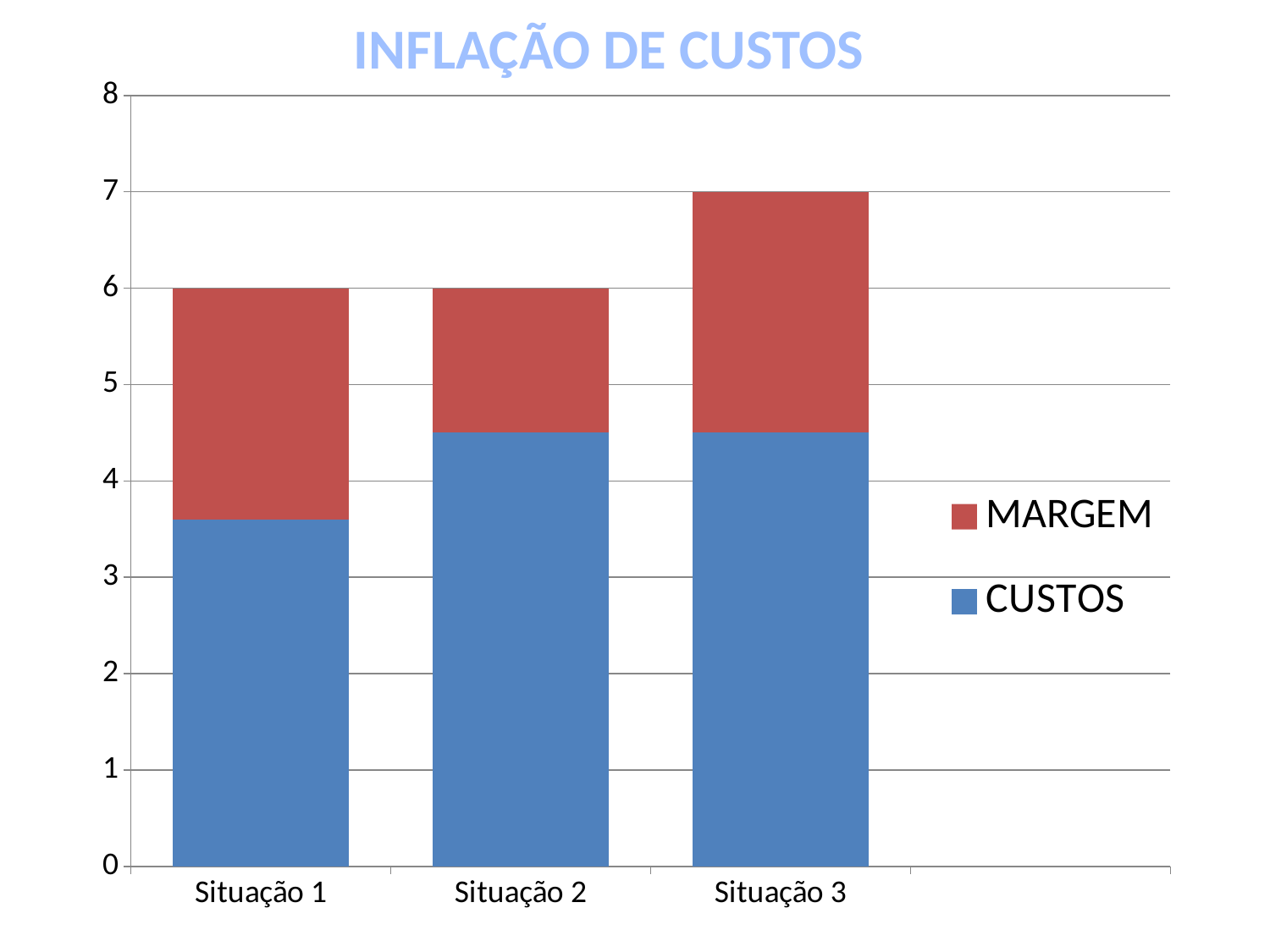
How many categories are shown on the x axis? 3 What is the total height of the stacked bar for Situação 3? 7 How many series does the legend list? 2 Is the CUSTOS value for Situação 1 greater or less than 4? less What is the difference between the total for Situação 3 and the total for Situação 2? 1 Is the CUSTOS value for Situação 2 greater or less than 4? greater Which category has the smallest MARGEM segment? Situação 2 What is the title of the chart? INFLAÇÃO DE CUSTOS Which category has the highest total stacked bar? Situação 3 What kind of chart is shown on the slide? Stacked bar chart Which is larger, the CUSTOS value for Situação 1 or for Situação 2? Situação 2 What is the total height of the stacked bar for Situação 1? 6